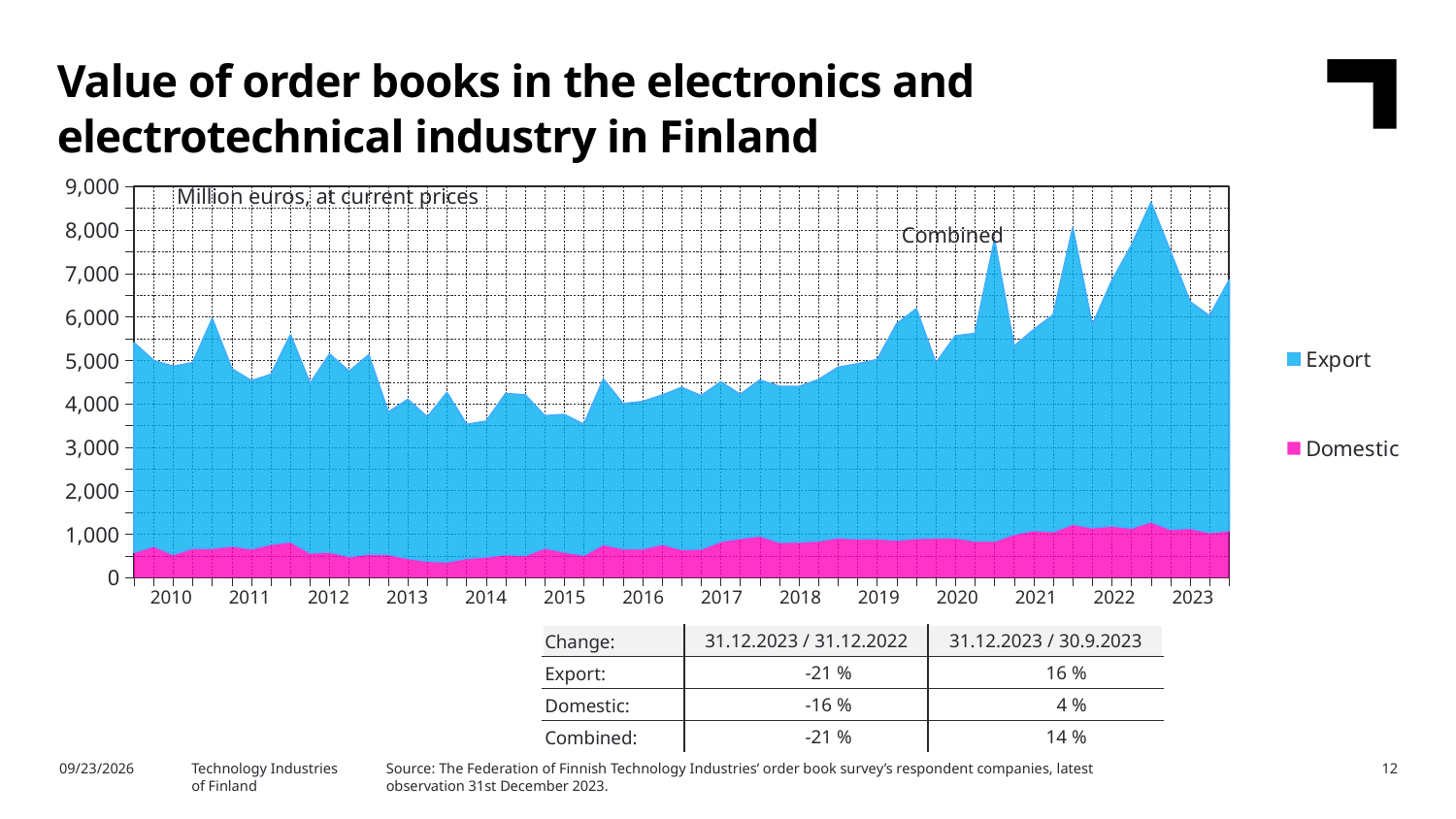
Which series is larger throughout the chart, Export or Domestic? Export How many series does the chart's legend list? 2 Is the peak Domestic value in 2022 greater or less than 1,000? greater How many years are labelled on the x axis of the chart? 14 What unit is stated in the chart's subtitle? Million euros, at current prices Is the Domestic value in 2010 greater or less than 1,000? less What kind of chart is shown on the slide? Stacked area chart Is the combined value at the start of 2010 greater or less than 5,000? greater Does the Domestic series generally rise or fall from 2010 to 2023? Rise In which year does the combined value of order books reach its highest peak? 2022 What are the two series named in the chart's legend? Export and Domestic